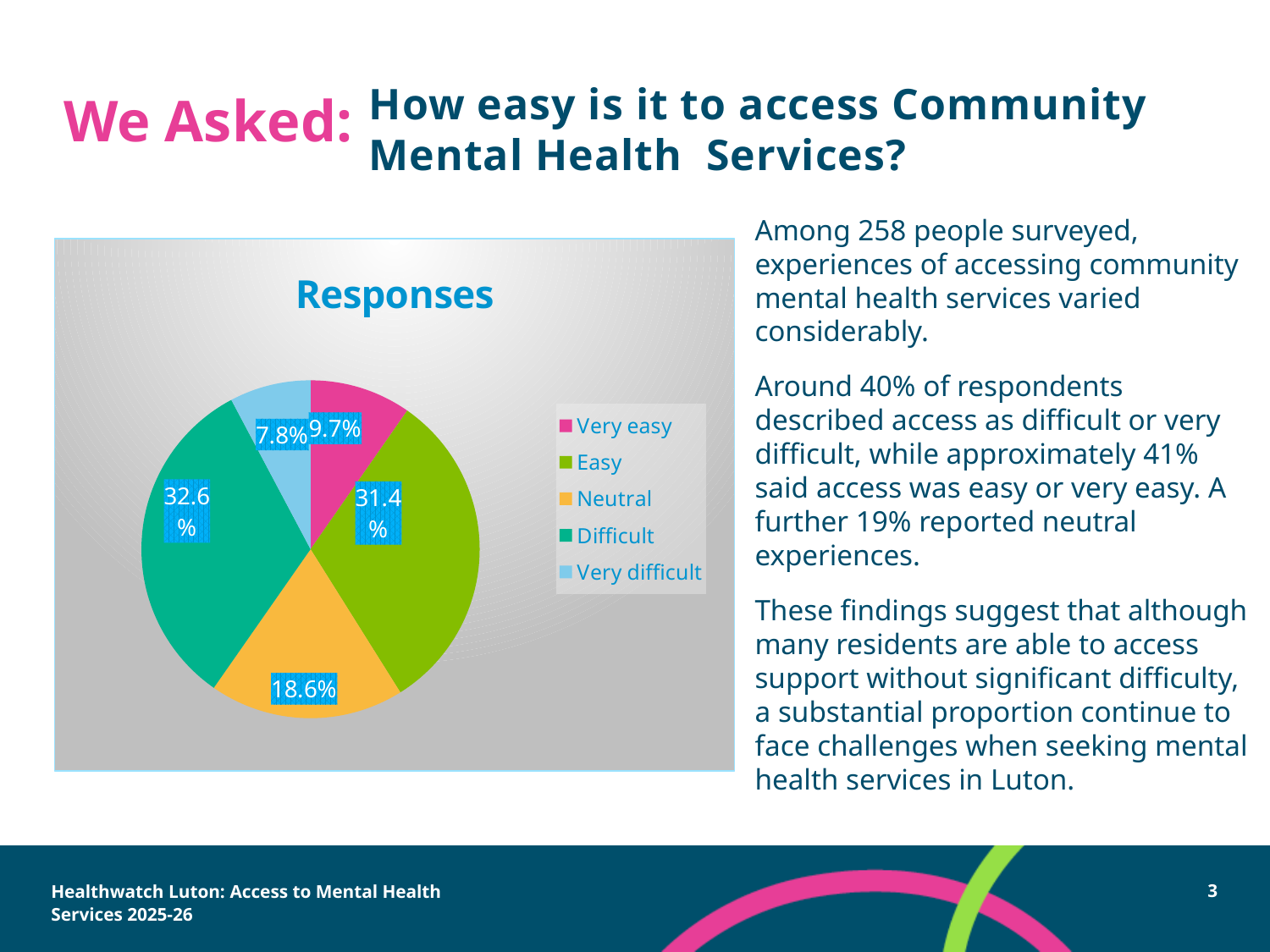
What is the difference between the 'Neutral' and 'Very easy' shares? 8.9% What is the title of the chart? Responses Which response category has the largest share of the pie? Difficult What percentage of responses were 'Very easy'? 9.7% What percentage of responses were 'Difficult'? 32.6% Which response category has the smallest share of the pie? Very difficult How many categories does the legend list? 5 What percentage of responses were 'Easy'? 31.4% What percentage of responses were 'Very difficult'? 7.8% What percentage of responses were 'Neutral'? 18.6% What kind of chart is shown on the slide? Pie chart Which is larger, the 'Neutral' share or the 'Very difficult' share? Neutral